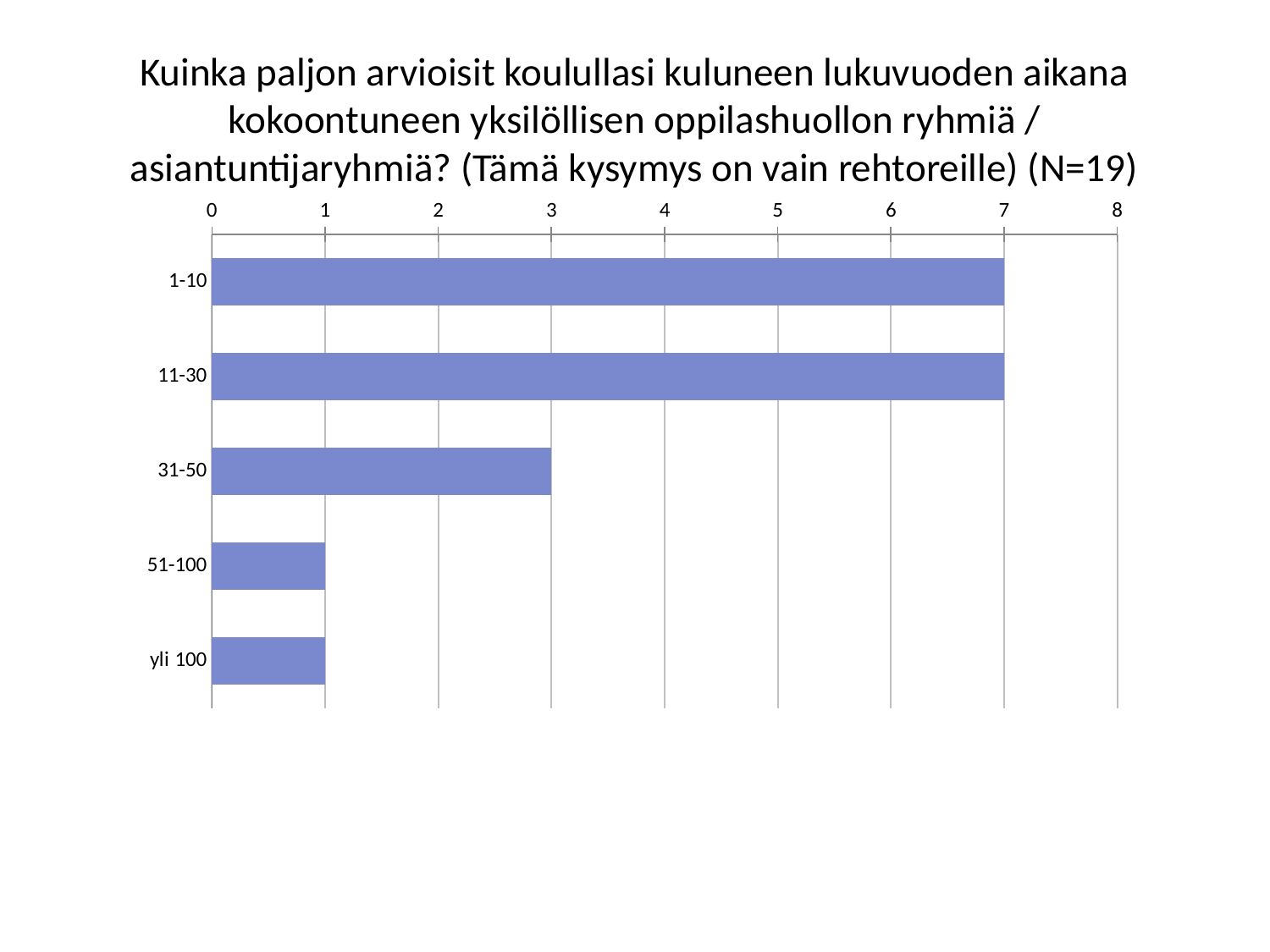
What is the value for the category 51-100? 1 What kind of chart is shown on the slide? bar chart What is the value for the category 11-30? 7 What is the value for the category yli 100? 1 What is the difference between the value for 11-30 and the value for 31-50? 4 What is the difference between the value for 31-50 and the value for 51-100? 2 Which is larger, the value for 1-10 or the value for 31-50? 1-10 Is the value for 31-50 greater or less than 2? greater What is the value for the category 31-50? 3 What is the value for the category 1-10? 7 How many categories are shown on the chart? 5 What is the N value given in the chart title? N=19